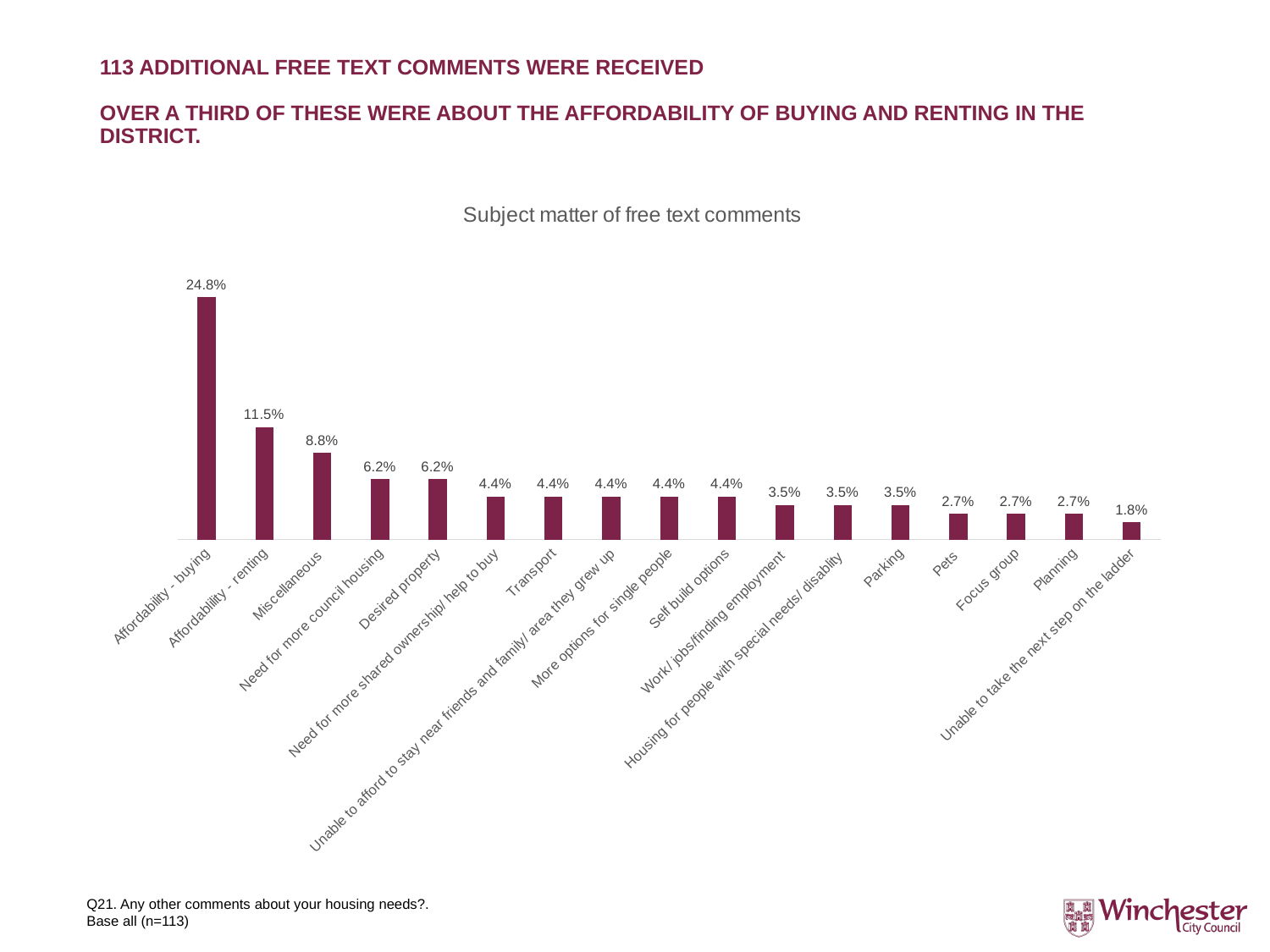
What is the value for Affordability - buying? 24.8% How many categories are shown in the chart? 17 What is the value for Miscellaneous? 8.8% What kind of chart is shown on the slide? Bar chart Which is larger, Affordability - renting or Need for more council housing? Affordability - renting What is the value for Parking? 3.5% Which category has the highest value? Affordability - buying Which category has the lowest value? Unable to take the next step on the ladder What is the difference between Miscellaneous and Pets? 6.1% What is the value for Transport? 4.4% What is the difference between Affordability - buying and Affordability - renting? 13.3% What is the title of the chart? Subject matter of free text comments